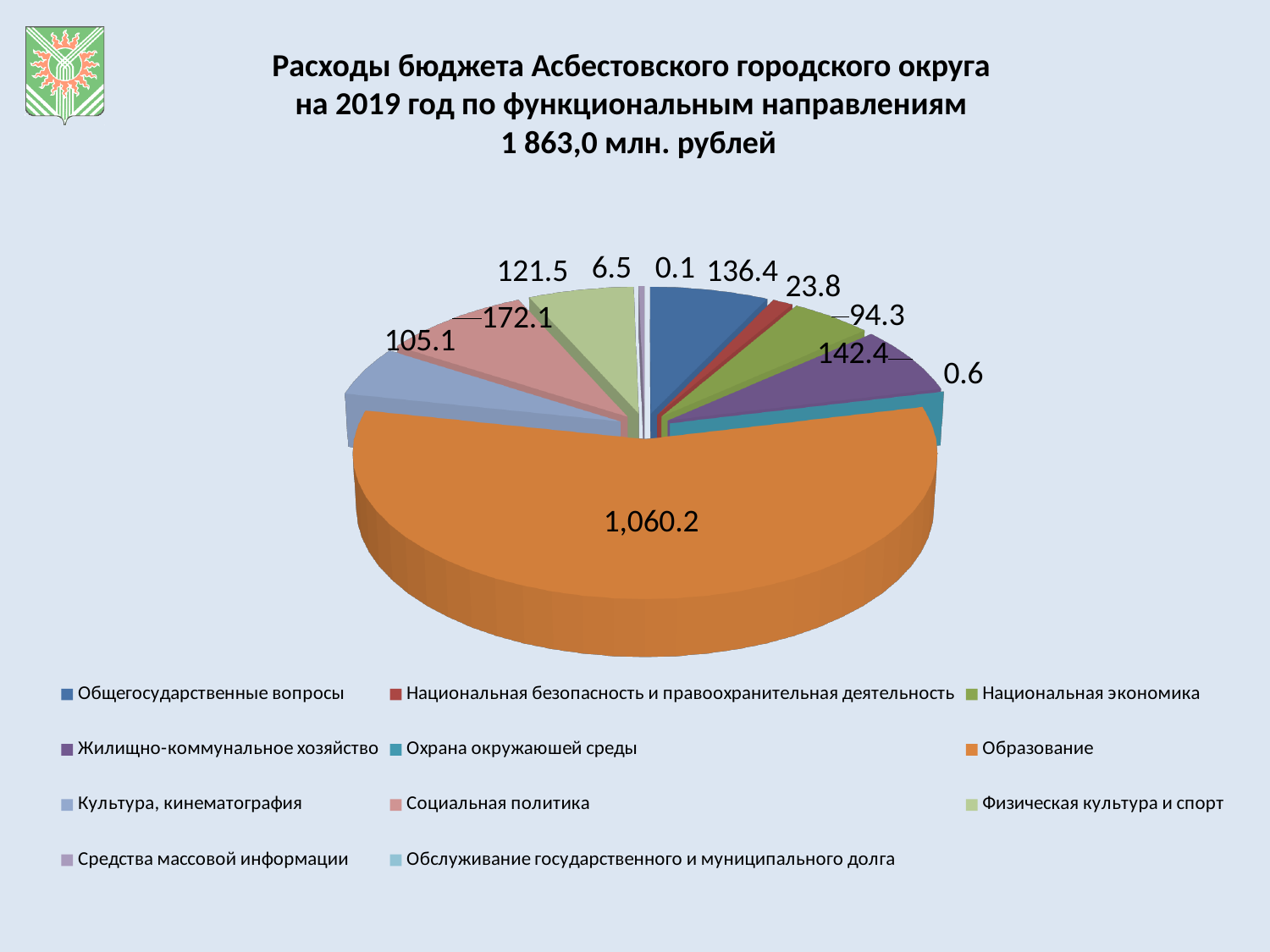
What is the difference between the values for Социальная политика and Культура, кинематография? 67.0 Which category has the smallest value? Обслуживание государственного и муниципального долга What is the value for Социальная политика? 172.1 What share of the total 1 863,0 does Образование (1,060.2) represent? 56.9% What is the value for Образование? 1,060.2 What kind of chart is shown on the slide? pie chart Which category has the largest slice of the pie? Образование How many categories does the legend list? 11 Which is larger, the value for Физическая культура и спорт or the value for Национальная экономика? Физическая культура и спорт What total amount is stated in the chart title? 1 863,0 млн. рублей What is the value for Национальная безопасность и правоохранительная деятельность? 23.8 What is the value for Жилищно-коммунальное хозяйство? 142.4